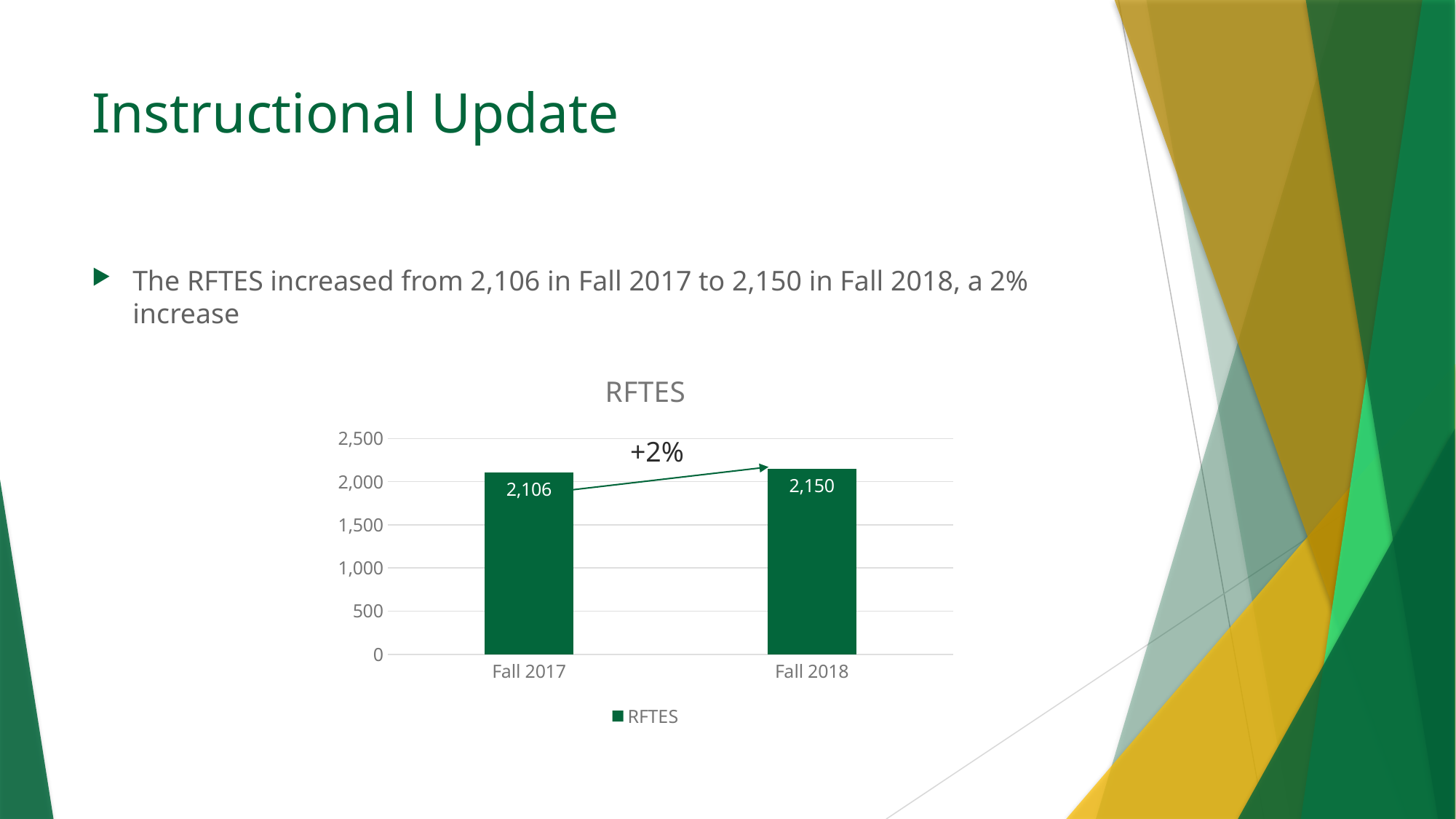
Which category has the higher RFTES value? Fall 2018 What percentage change is annotated on the chart between the two bars? +2% Do the RFTES values rise or fall from Fall 2017 to Fall 2018? Rise Is the RFTES value for Fall 2017 greater or less than 2,000? greater How many categories are shown on the x axis of the chart? 2 What is the RFTES value for Fall 2018? 2,150 What kind of chart is shown on the slide? Bar chart What is the RFTES value for Fall 2017? 2,106 What is the difference between the RFTES values for Fall 2018 and Fall 2017? 44 How many series does the chart legend list? 1 Which category has the lower RFTES value? Fall 2017 Is the RFTES value for Fall 2018 greater or less than 2,500? less